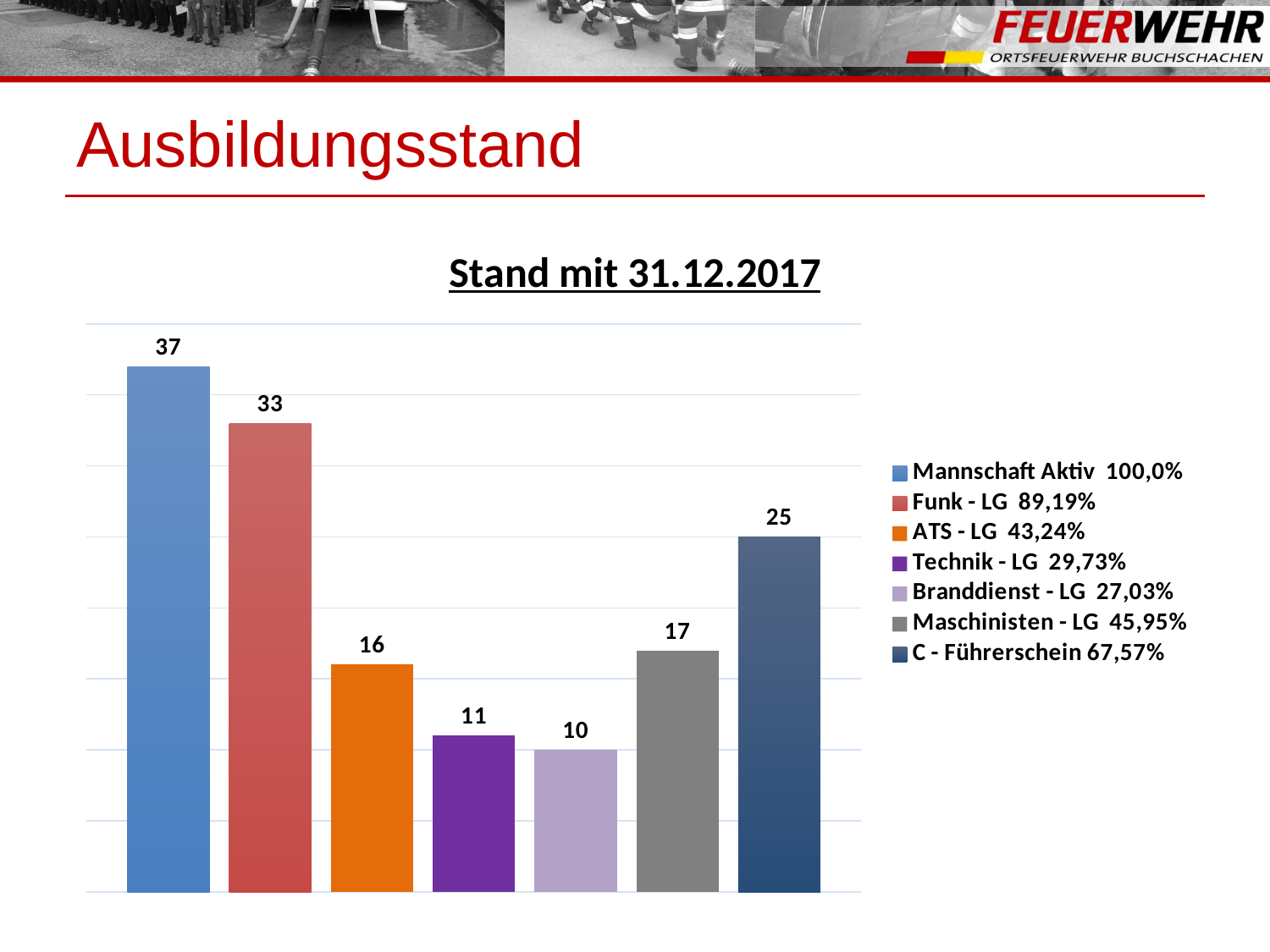
What percentage is shown in the legend for Technik - LG? 29,73% What is the value for Mannschaft Aktiv? 37 What is the value for C - Führerschein? 25 What is the value for Branddienst - LG? 10 Which is larger, the value for ATS - LG or the value for Maschinisten - LG? Maschinisten - LG What is the value for Funk - LG? 33 Which category has the lowest value? Branddienst - LG What is the difference between the values for Mannschaft Aktiv and Funk - LG? 4 How many bars are shown in the chart? 7 What kind of chart is shown on the slide? Bar chart Which category has the highest value? Mannschaft Aktiv How many entries does the legend list? 7